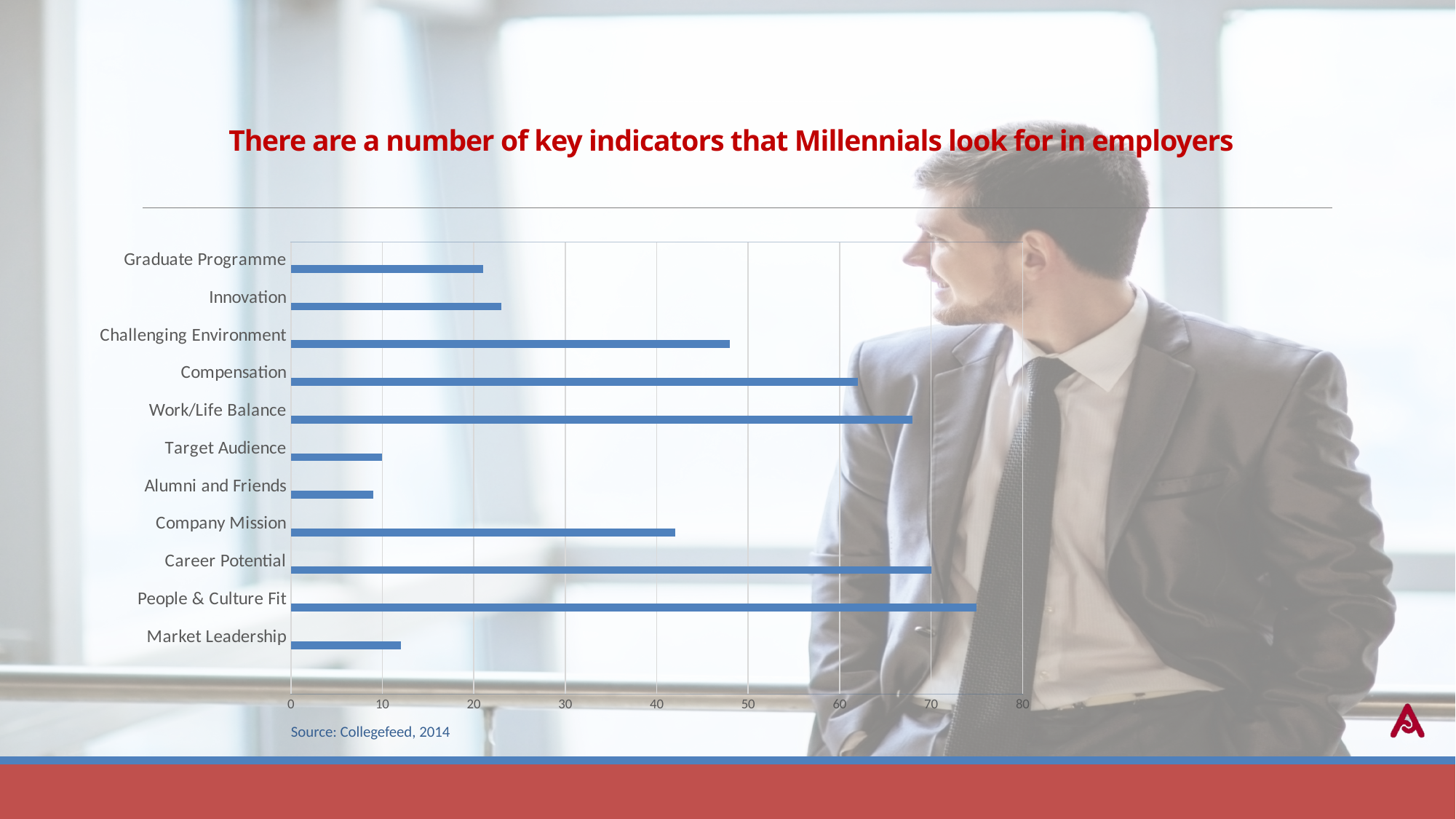
Which is larger, the value for Career Potential or the value for Company Mission? Career Potential What source is cited below the chart? Collegefeed, 2014 Is the value for Market Leadership greater or less than 20? less Is the value for Company Mission greater or less than 40? greater Is the value for Work/Life Balance greater or less than 70? less Which category has the highest value in the chart? People & Culture Fit Which is larger, the value for Compensation or the value for Challenging Environment? Compensation What kind of chart is shown on the slide? bar chart How many categories are plotted in the chart? 11 What is the title of the slide? There are a number of key indicators that Millennials look for in employers